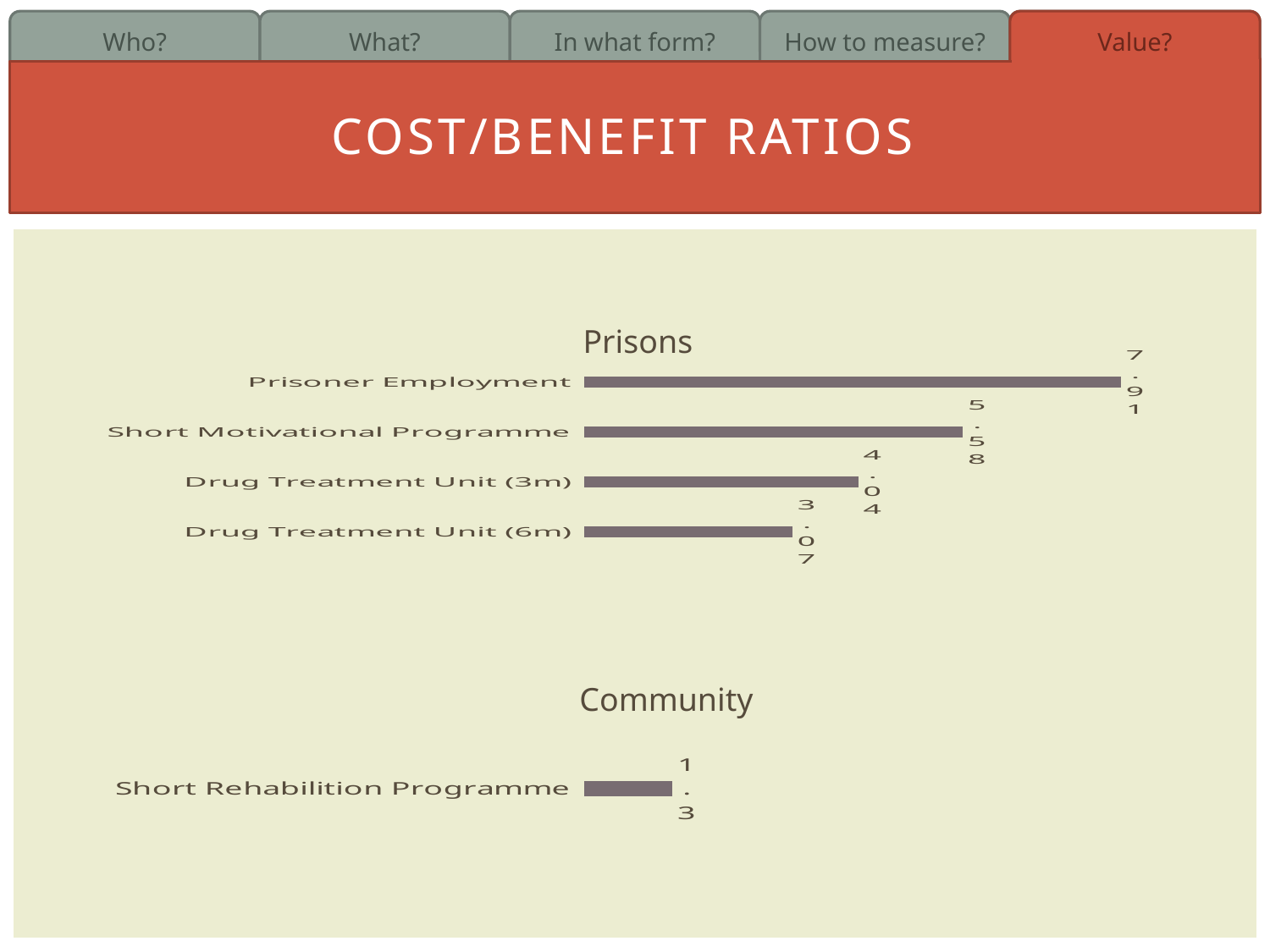
In the Prisons chart, what is the value for Short Motivational Programme? 5.58 How many categories are shown in the Prisons chart? 4 In the Community chart, what is the value for Short Rehabilition Programme? 1.3 In the Prisons chart, what is the value for Prisoner Employment? 7.91 What kind of chart is the Community chart? Bar chart In the Prisons chart, which category has the highest value? Prisoner Employment In the Prisons chart, what is the difference between the values for Prisoner Employment and Short Motivational Programme? 2.33 In the Prisons chart, which is larger: Drug Treatment Unit (3m) or Drug Treatment Unit (6m)? Drug Treatment Unit (3m) What is the title of the slide? COST/BENEFIT RATIOS In the Prisons chart, what is the value for Drug Treatment Unit (6m)? 3.07 In the Prisons chart, what is the value for Drug Treatment Unit (3m)? 4.04 In the Prisons chart, which category has the lowest value? Drug Treatment Unit (6m)